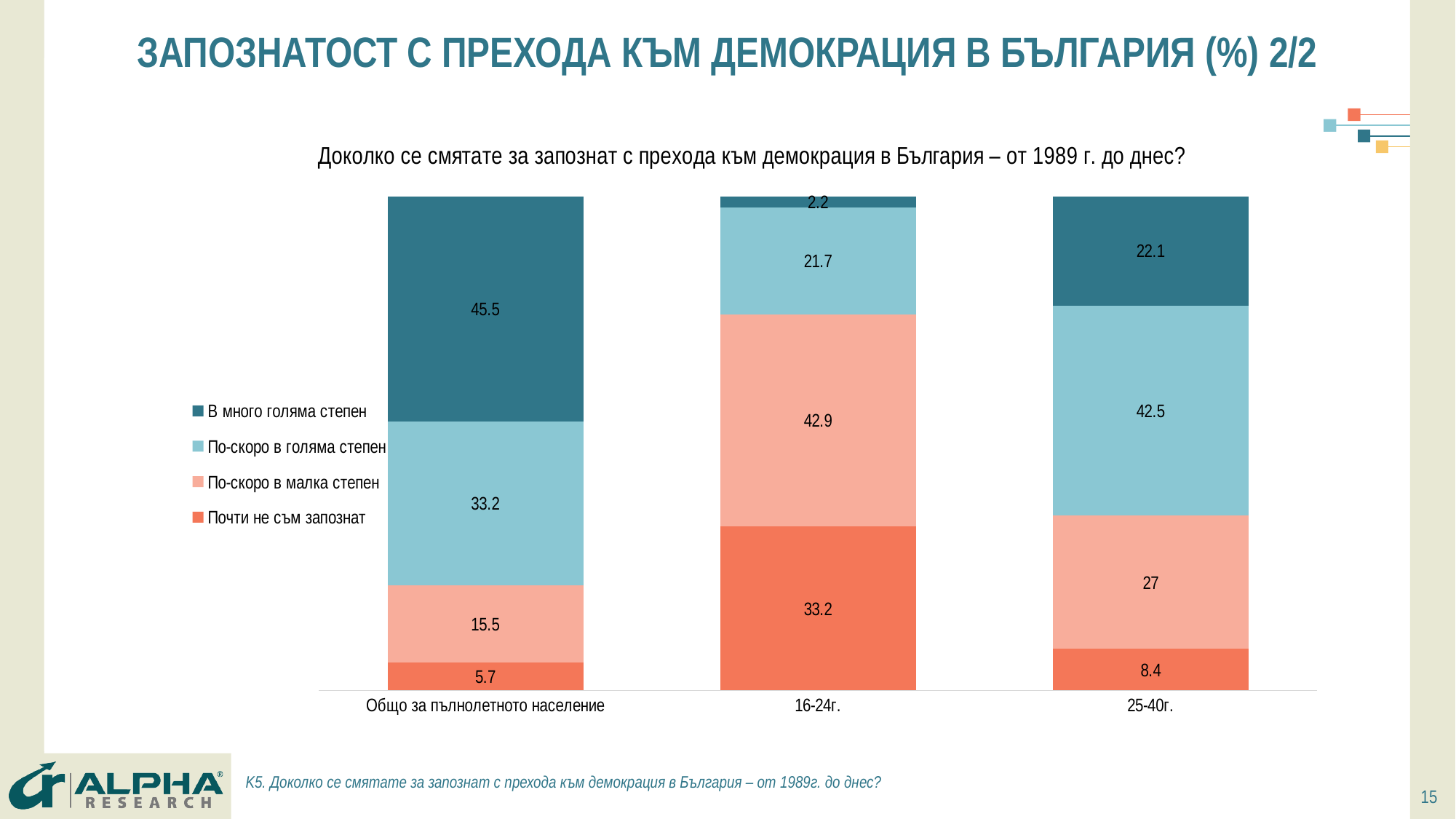
What is the value for "В много голяма степен" in the "16-24г." bar? 2.2 What is the value for "Почти не съм запознат" in the "16-24г." bar? 33.2 How many categories are shown along the x axis? 3 What is the total of the stacked bar for "25-40г."? 100 What type of chart is shown on the slide? stacked bar chart How many series does the legend list? 4 Which is larger: the "По-скоро в малка степен" value for "16-24г." or for "25-40г."? 16-24г. Which category has the highest value for "В много голяма степен"? Общо за пълнолетното население Which category has the lowest value for "Почти не съм запознат"? Общо за пълнолетното население What is the difference between the "По-скоро в голяма степен" values for "25-40г." and "16-24г."? 20.8 What is the value for "По-скоро в малка степен" in the "25-40г." bar? 27 What is the value for "В много голяма степен" in the "Общо за пълнолетното население" bar? 45.5